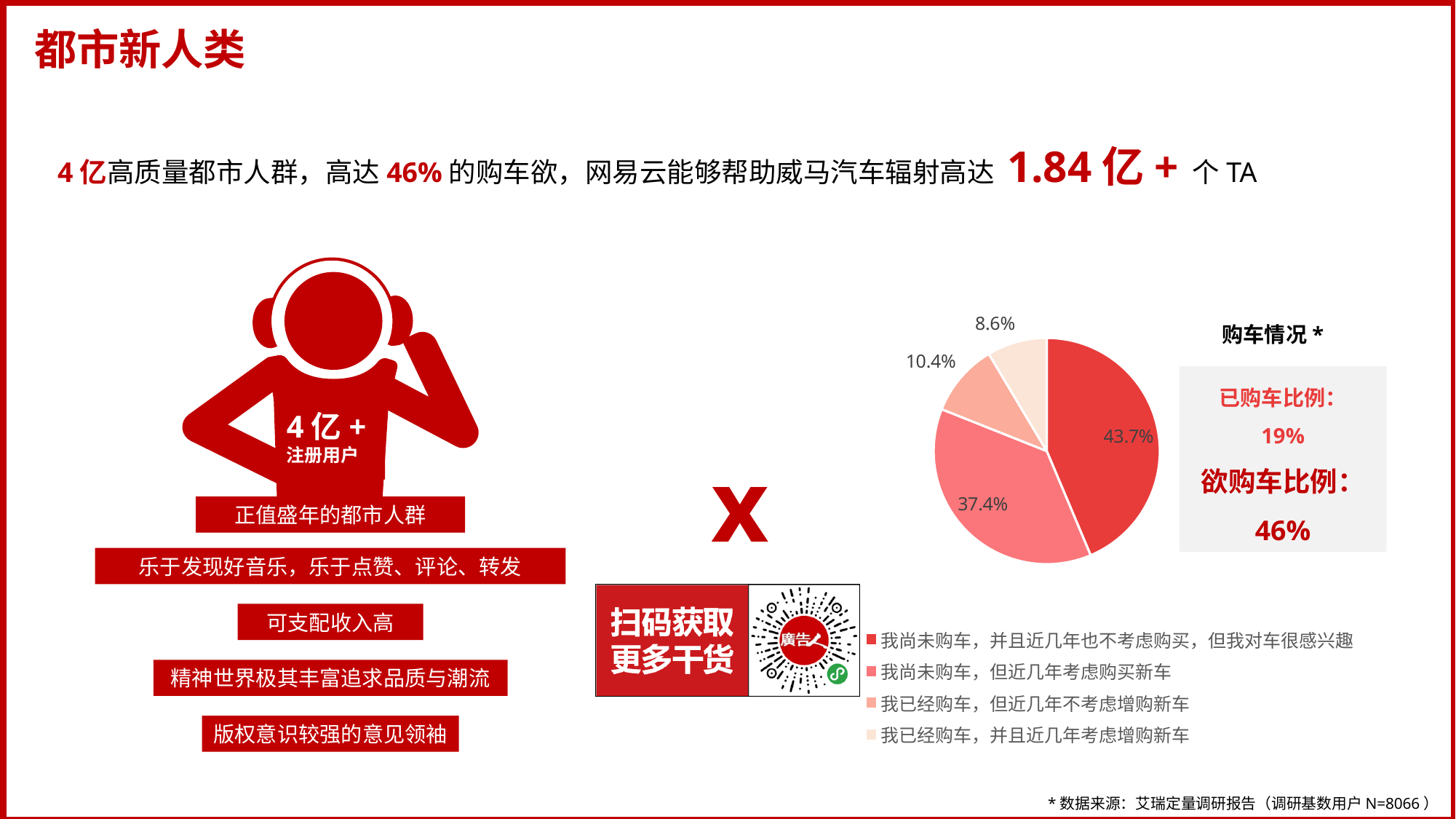
Which category has the largest slice in the 购车情况 * pie chart? 我尚未购车，并且近几年也不考虑购买，但我对车很感兴趣 What kind of chart is shown under the title 购车情况 *? pie chart What is the title of the pie chart on the slide? 购车情况 * Which category has the smallest slice in the 购车情况 * pie chart? 我已经购车，并且近几年考虑增购新车 In the 购车情况 * pie chart, what is the value for 我已经购车，但近几年不考虑增购新车? 10.4% In the 购车情况 * pie chart, which is larger: 我已经购车，但近几年不考虑增购新车 or 我已经购车，并且近几年考虑增购新车? 我已经购车，但近几年不考虑增购新车 How many slices does the 购车情况 * pie chart have? 4 How many entries does the legend of the 购车情况 * pie chart list? 4 In the 购车情况 * pie chart, what is the value for 我已经购车，并且近几年考虑增购新车? 8.6% In the 购车情况 * pie chart, what is the value for 我尚未购车，并且近几年也不考虑购买，但我对车很感兴趣? 43.7% In the 购车情况 * pie chart, what is the value for 我尚未购车，但近几年考虑购买新车? 37.4% In the 购车情况 * pie chart, what is the difference between the 43.7% slice and the 37.4% slice? 6.3%